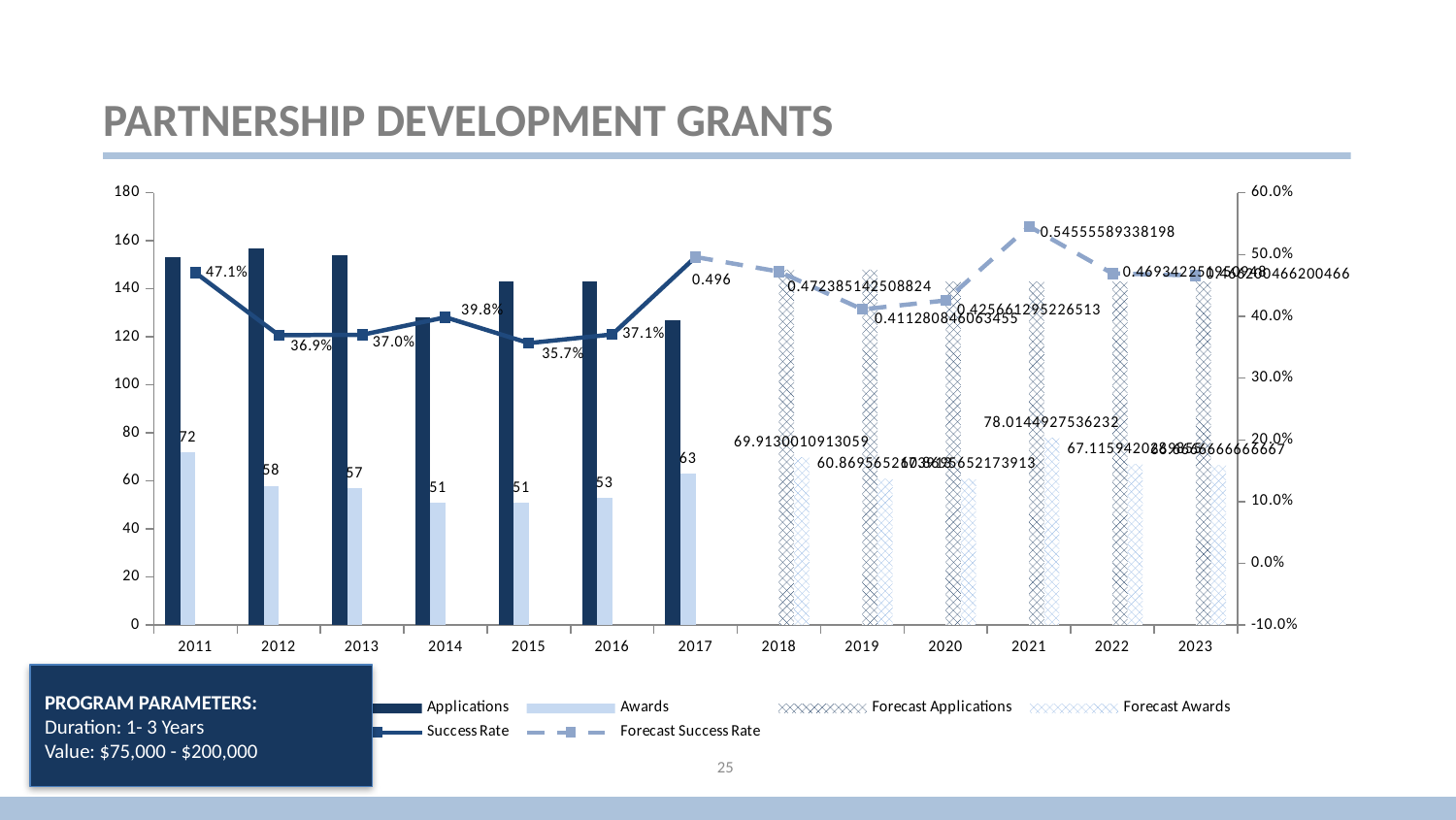
What is the Forecast Awards value labelled for 2021? 78.0144927536232 What is the difference between the Awards values for 2011 and 2012? 14 What is the value of Awards in 2017? 63 How many series does the legend list? 6 Is the Applications value for 2014 greater or less than 140? less Among the years 2011 to 2017, which year has the highest Awards value? 2011 What is the Success Rate shown for 2015? 35.7% What is the Success Rate shown for 2011? 47.1% How many years are shown on the x axis? 13 Among the years 2011 to 2017, which year has the lowest Success Rate? 2015 What is the value of Awards in 2011? 72 Which year has the larger Awards value, 2012 or 2013? 2012